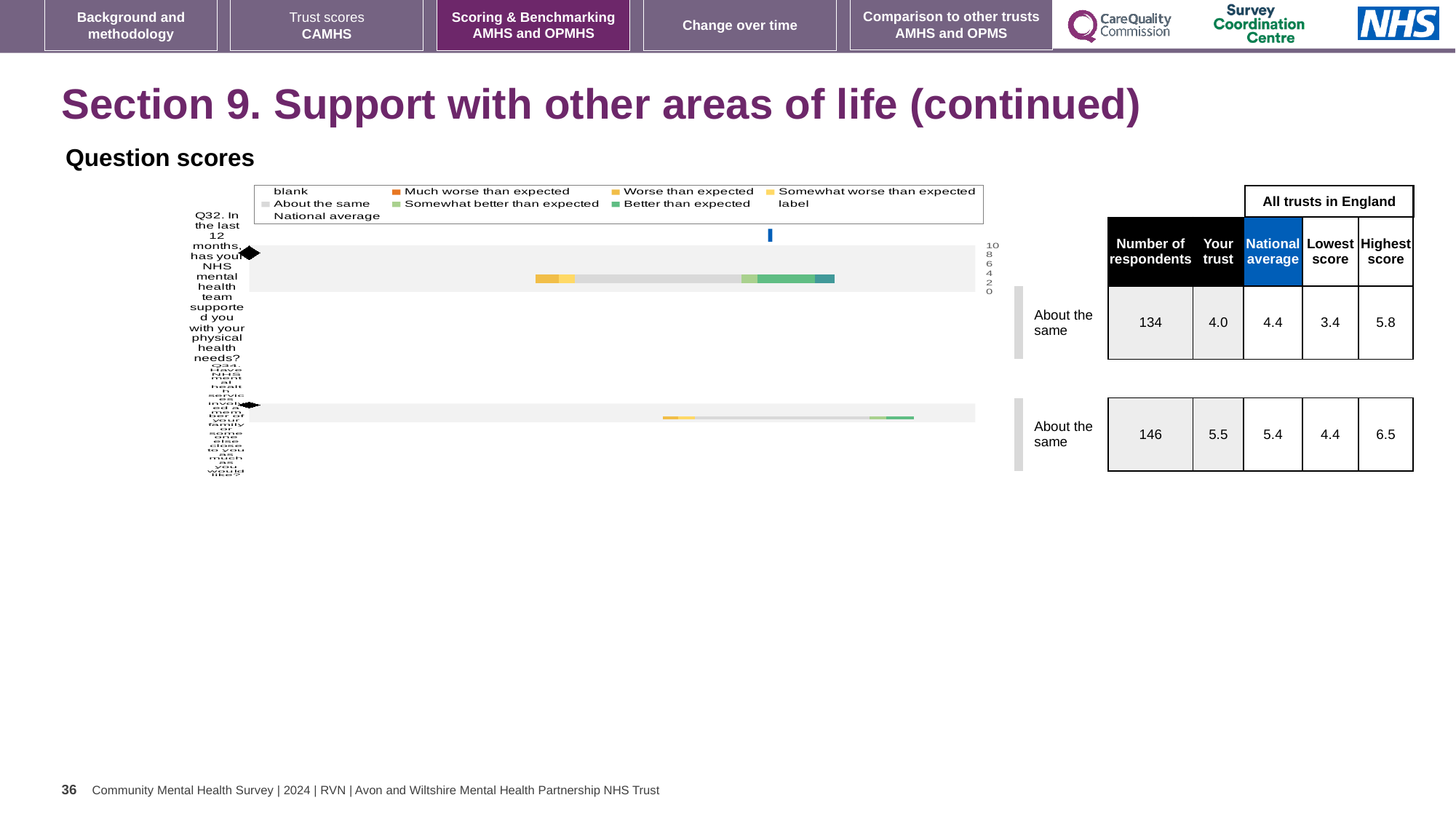
Which legend entry is shown in grey? About the same How many entries does the chart legend list? 9 In the table next to the chart, what is the highest score for Q34? 6.5 What kind of chart is shown under 'Question scores'? bar chart In the table next to the chart, what is the national average for Q32? 4.4 Which legend entry is shown in orange? Much worse than expected In the table next to the chart, what is the number of respondents for Q32? 134 In the table, what is the difference between the highest score and the lowest score for Q34? 2.1 In the table, what is the difference between the highest score and the lowest score for Q32? 2.4 In the table, which is larger for Q32: the 'Your trust' score or the national average? National average How many questions (bars) are plotted in the chart? 2 In the table next to the chart, what is the 'Your trust' score for Q34? 5.5